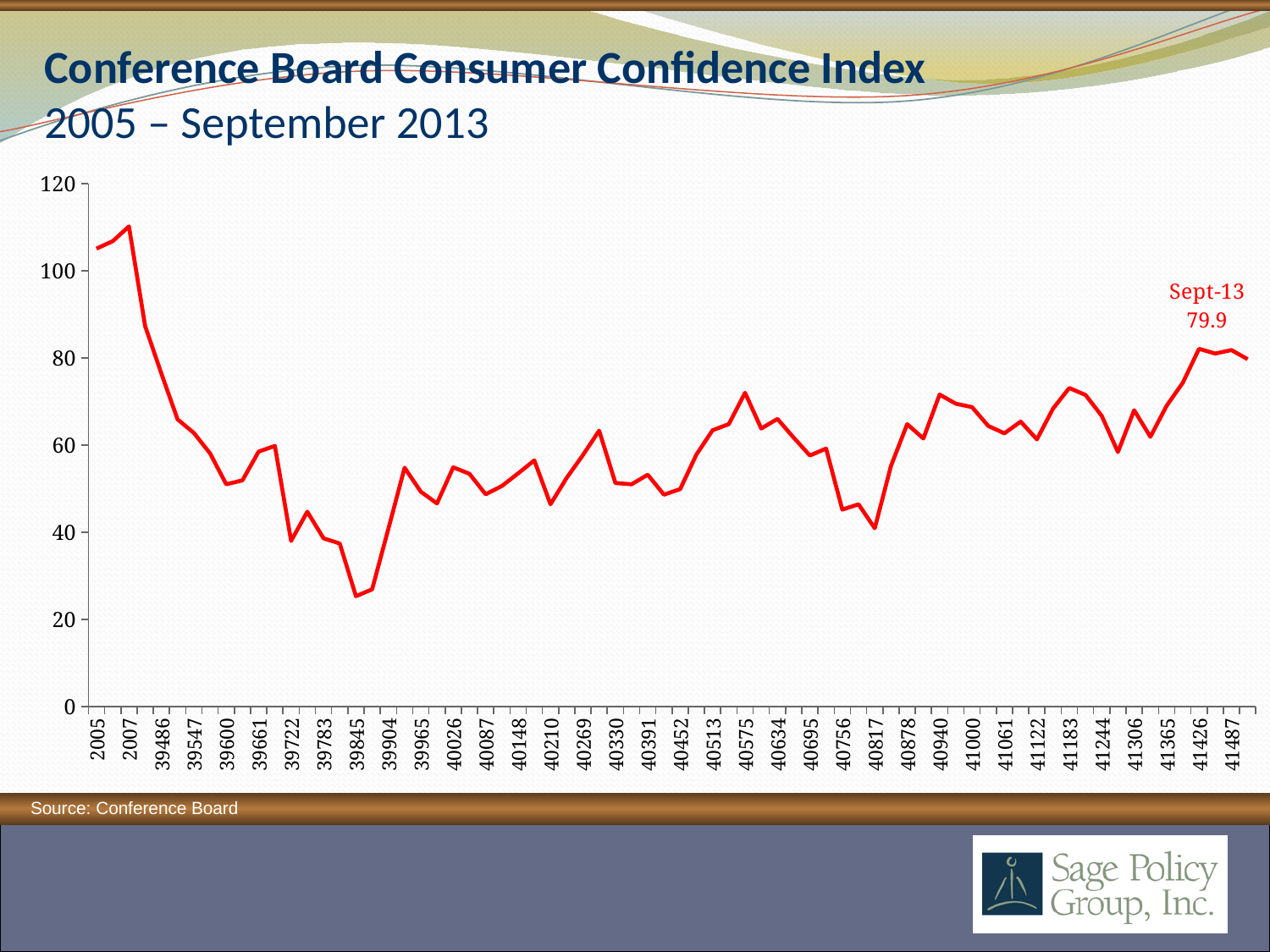
What source is cited for the chart? Conference Board Does the line rise or fall between the x-axis labels 2007 and 39486? fall Is the value at the x-axis label 41426 greater or less than 80? greater Which x-axis label corresponds to the lowest point on the line? 39845 Is the value at the x-axis label 39845 greater or less than 40? less What is the title of the chart on the slide? Conference Board Consumer Confidence Index 2005 – September 2013 Is the value at the x-axis label 40817 greater or less than 60? less What is the value of the Consumer Confidence Index labelled for Sept-13? 79.9 Does the line rise or fall between the x-axis labels 41306 and 41426? rise Which x-axis label corresponds to the highest point on the line? 2007 What kind of chart is shown on the slide? line chart